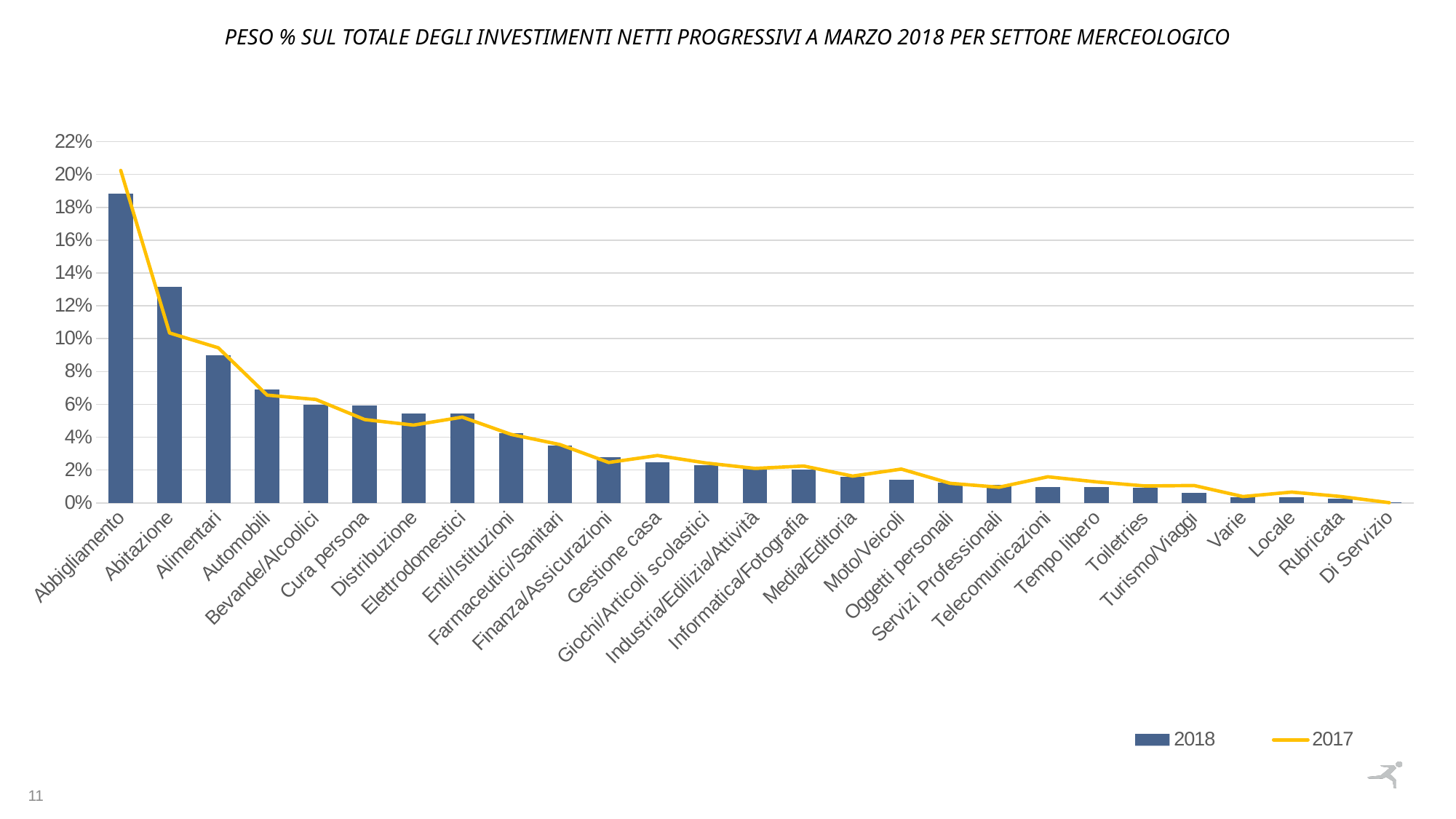
Do the 2018 values generally rise or fall from left to right along the x axis? fall Is the 2018 value for Gestione casa greater or less than 4%? less Which sector has the lowest value for 2018? Di Servizio Is the 2017 value for Abbigliamento greater or less than 18%? greater How many series does the legend list? 2 How many sectors are shown on the x axis? 27 For Abbigliamento, which is larger: the 2017 value or the 2018 value? 2017 Which sector has the highest value for 2018? Abbigliamento Is the 2018 value for Abitazione greater or less than 12%? greater Which is larger for 2018: Abitazione or Alimentari? Abitazione